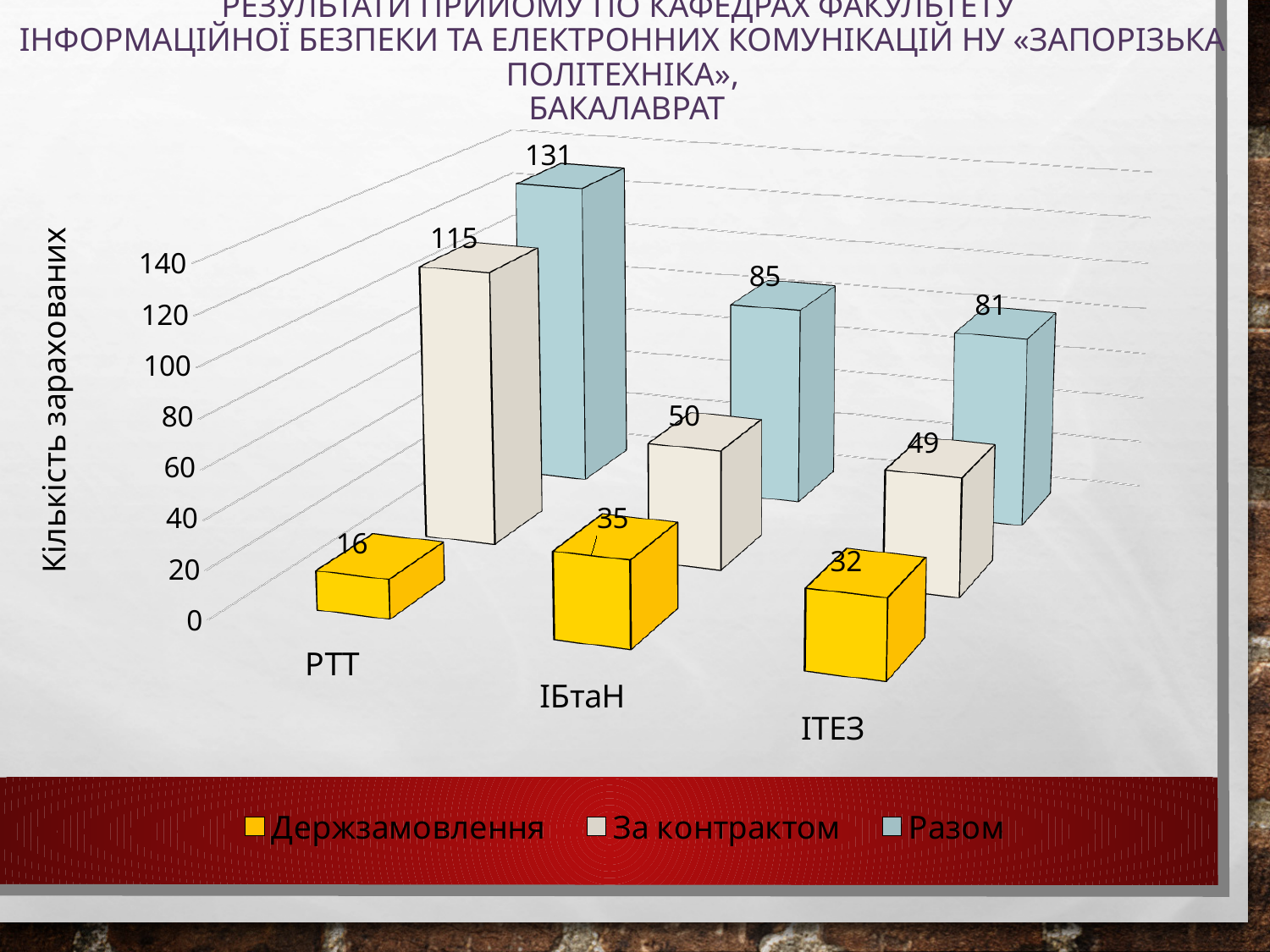
What kind of chart is shown on the slide? bar chart Which is larger: Держзамовлення for ІБтаН or Держзамовлення for ІТЕЗ? ІБтаН What is the label of the vertical axis? Кількість зарахованих Is the Разом value for ІБтаН greater or less than 100? less What is the value of Держзамовлення for РТТ? 16 What is the value of За контрактом for ІБтаН? 50 What is the difference between the За контрактом values for РТТ and ІТЕЗ? 66 How many series does the legend list? 3 How many categories are shown on the x axis? 3 What is the value of Разом for ІТЕЗ? 81 Which category has the highest Разом value? РТТ Which category has the lowest Держзамовлення value? РТТ